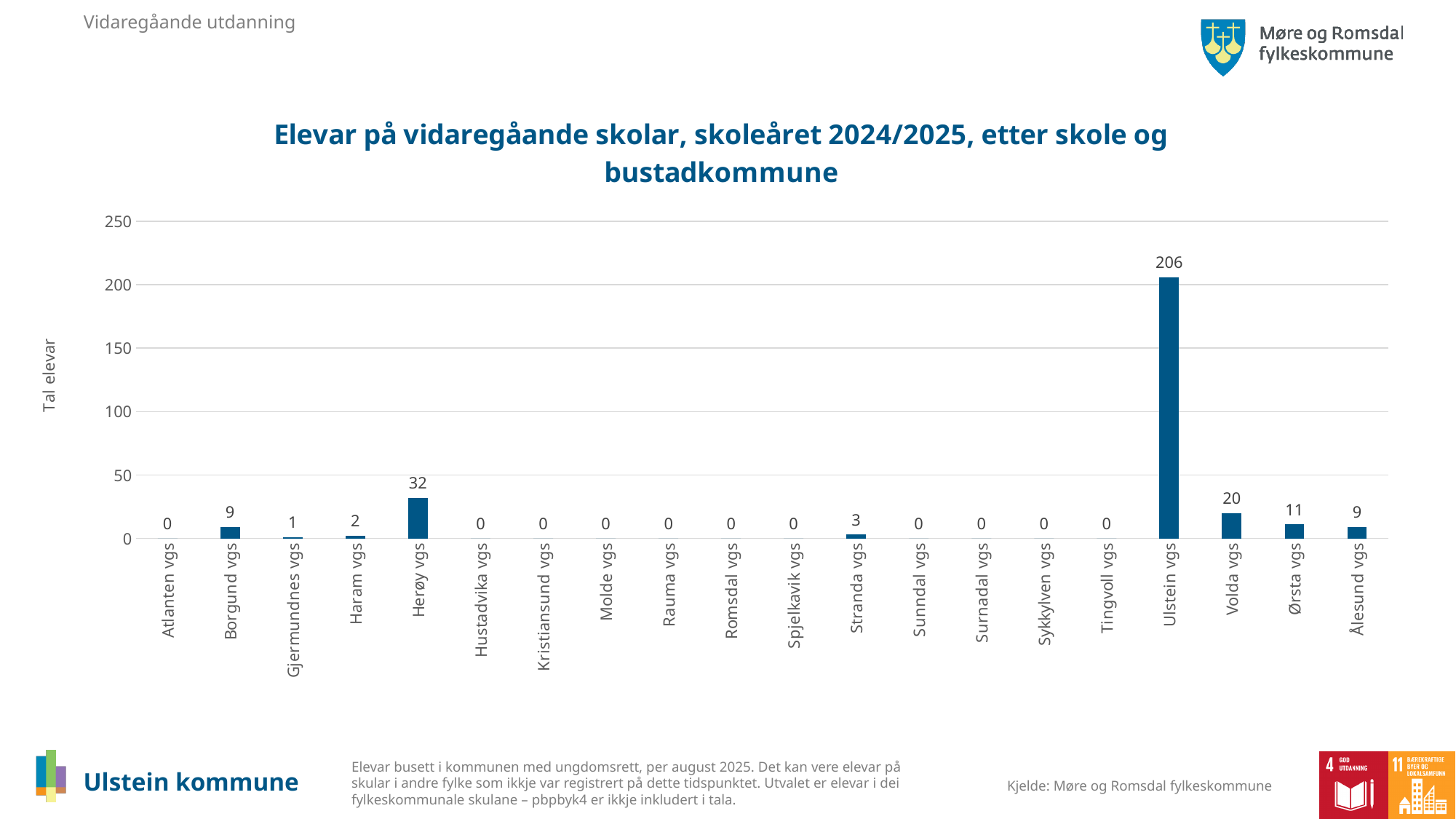
What is the value for Volda vgs? 20 Is the value for Ulstein vgs greater or less than 200? greater What kind of chart is shown on the slide? Bar chart What is the value for Herøy vgs? 32 Which is larger, the value for Borgund vgs or the value for Stranda vgs? Borgund vgs What is the label of the y axis? Tal elevar What is the value for Ulstein vgs? 206 How many schools are shown on the x axis? 20 What is the difference between the values for Ulstein vgs and Herøy vgs? 174 What is the difference between the values for Volda vgs and Ålesund vgs? 11 What is the value for Ørsta vgs? 11 Which school has the highest number of pupils? Ulstein vgs